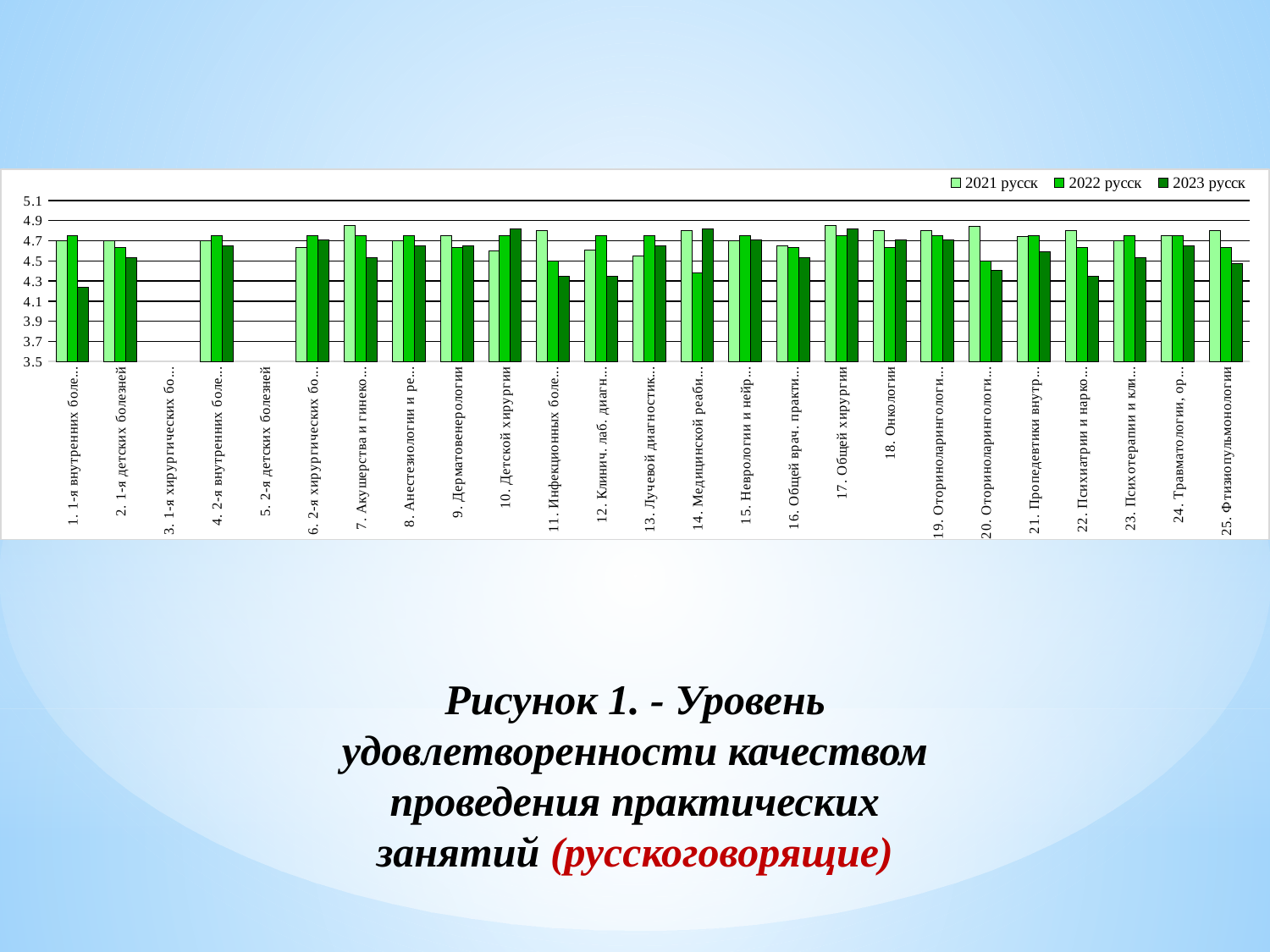
How many series does the legend list? 3 Is the 2022 русск value for "14. Медицинской реаби..." greater or less than 4.5? less What is the lowest value shown on the y axis of the chart? 3.5 Is the 2021 русск value for "17. Общей хирургии" greater or less than 4.7? greater For "10. Детской хирургии", which is larger: the 2021 русск value or the 2023 русск value? 2023 русск For "14. Медицинской реаби...", which is larger: the 2022 русск value or the 2023 русск value? 2023 русск What kind of chart is shown on the slide? bar chart Is the 2023 русск value for "10. Детской хирургии" greater or less than 4.7? greater How many categories on the x axis have no bars plotted at all? 2 What are the legend entries of the chart? 2021 русск, 2022 русск, 2023 русск How many categories are shown along the x axis? 25